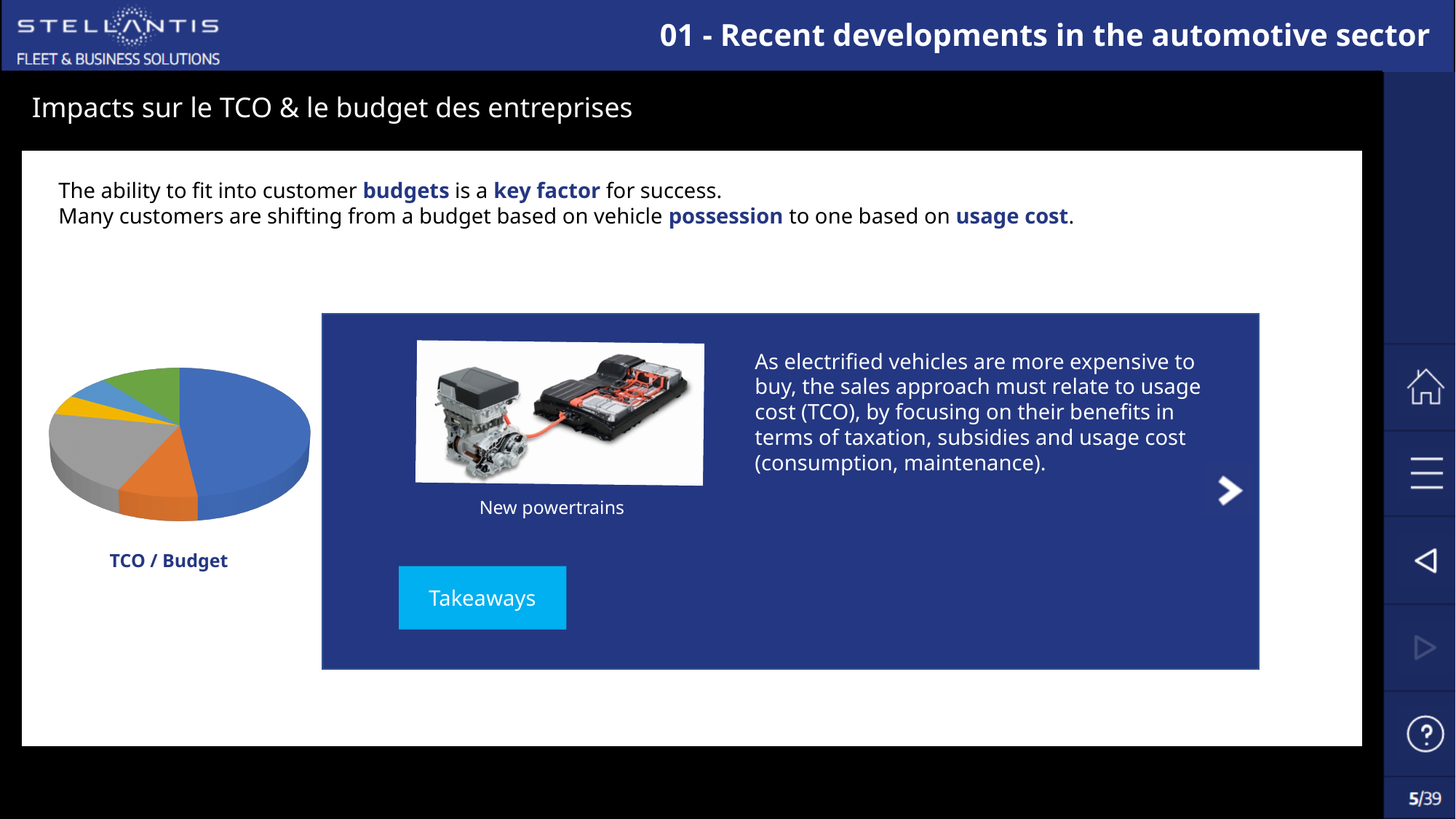
In the TCO / Budget pie chart, which is larger, the gray slice or the green slice? gray In the TCO / Budget pie chart, which is larger, the blue slice or the orange slice? blue Does the TCO / Budget pie chart display a legend? No In the TCO / Budget pie chart, which is larger, the orange slice or the yellow slice? orange What is the title shown beneath the pie chart? TCO / Budget What kind of chart is shown under the label "TCO / Budget"? pie chart Which colour slice is the largest in the TCO / Budget pie chart? blue How many slices does the TCO / Budget pie chart have? 6